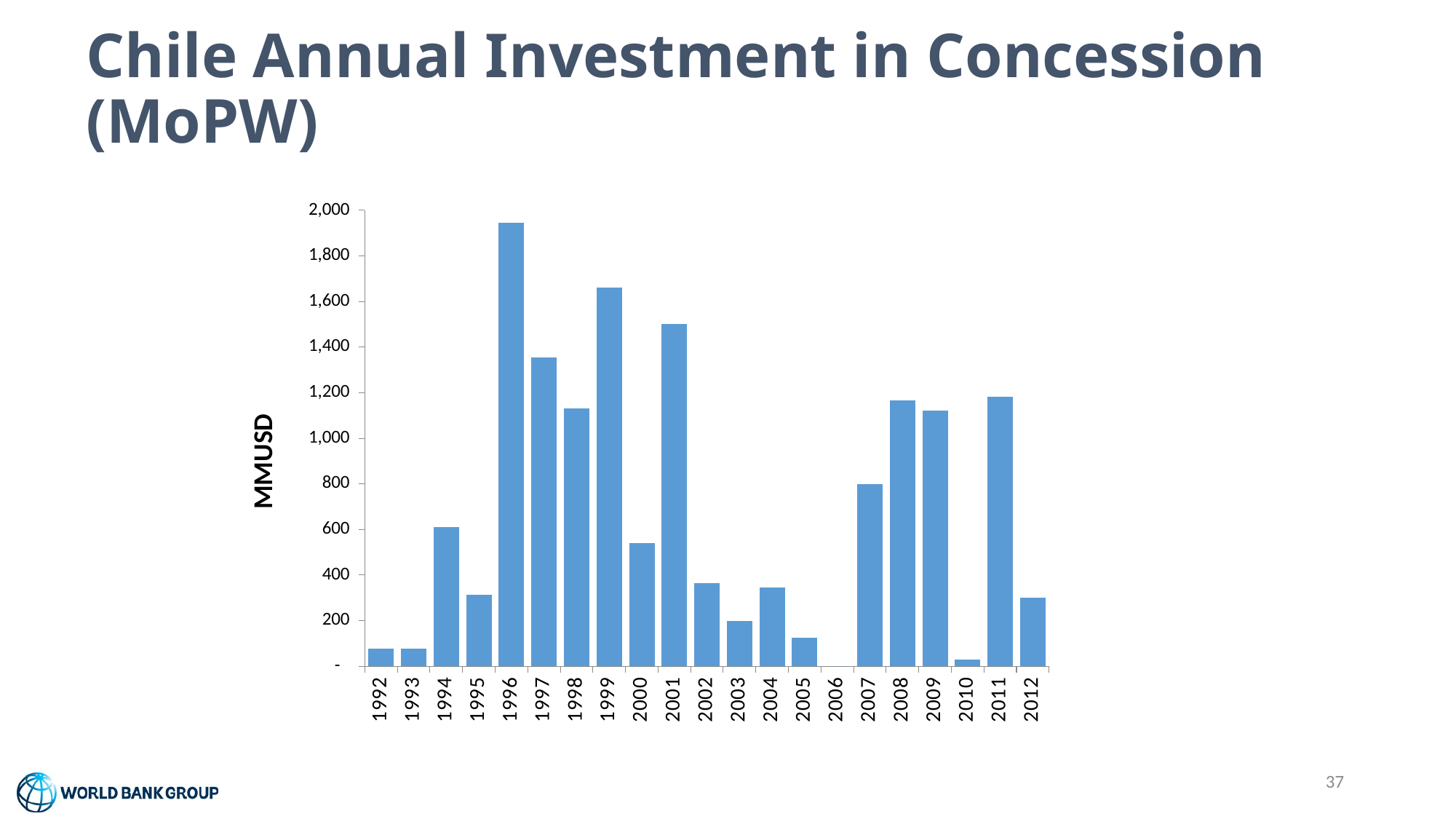
Which year has the highest annual investment in concession? 1996 Which year has the larger value, 2001 or 2008? 2001 Which year has the larger value, 1997 or 1998? 1997 What kind of chart is shown on the slide? bar chart Is the value for 2005 greater or less than 200? less Is the value for 1999 greater or less than 1,600? greater Is the value for 1996 greater or less than 1,800? greater How many years are shown on the x axis of the chart? 21 What is the label on the vertical axis of the chart? MMUSD Which year has the lowest annual investment in concession? 2006